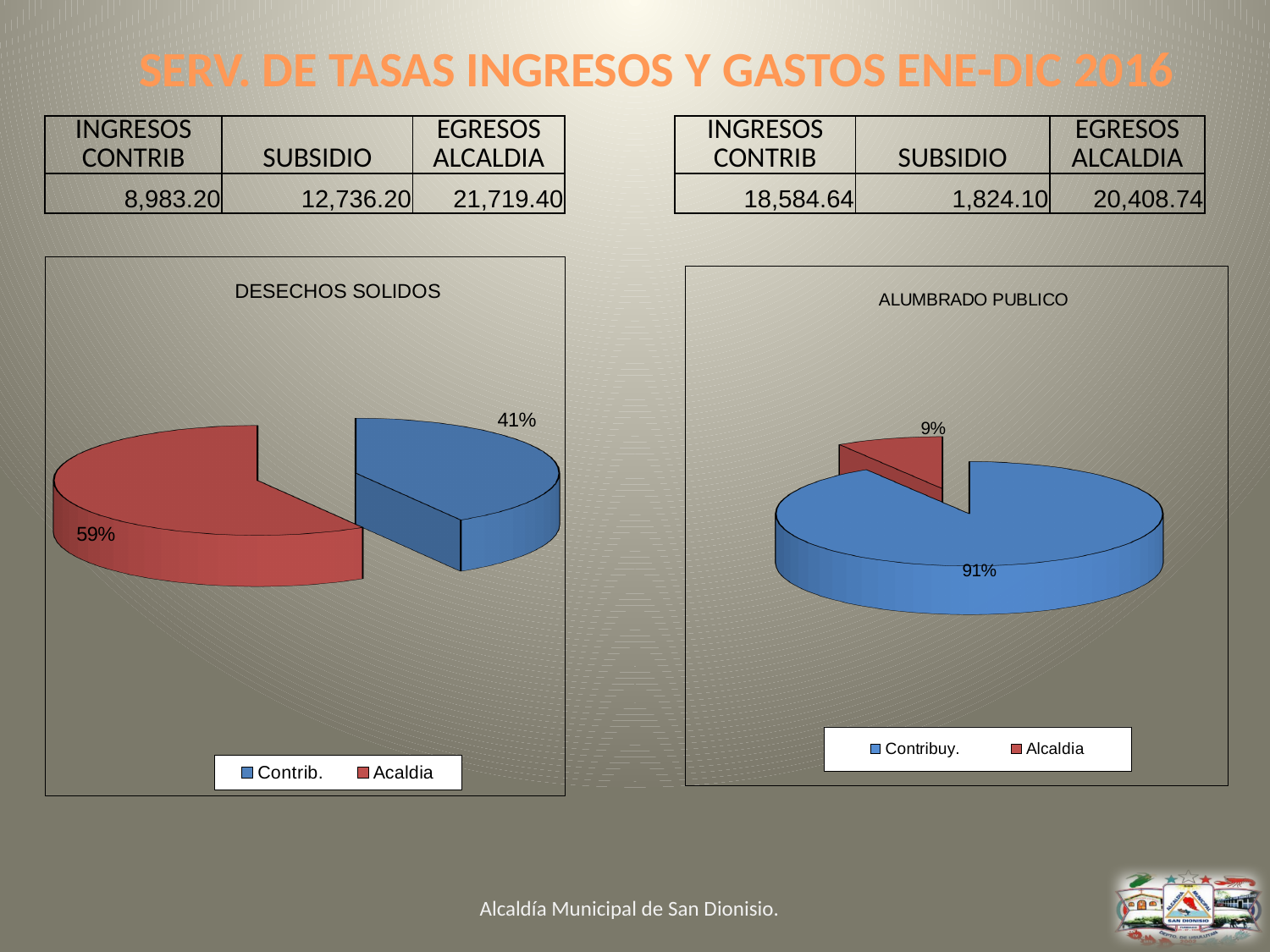
In the DESECHOS SOLIDOS chart, which slice is the largest? Acaldia In the ALUMBRADO PUBLICO chart, what share does Alcaldia have? 9% In the ALUMBRADO PUBLICO chart, which slice is the smallest? Alcaldia In the DESECHOS SOLIDOS chart, what share does Acaldia have? 59% In the ALUMBRADO PUBLICO chart, what is the difference in percentage points between Contribuy. and Alcaldia? 82 How many slices does the ALUMBRADO PUBLICO pie chart have? 2 In the DESECHOS SOLIDOS chart, what share does Contrib. have? 41% What kind of chart is the DESECHOS SOLIDOS chart? Pie chart In the ALUMBRADO PUBLICO chart, which is larger, Contribuy. or Alcaldia? Contribuy. How many entries does the legend of the DESECHOS SOLIDOS chart list? 2 In the DESECHOS SOLIDOS chart, what is the difference in percentage points between Acaldia and Contrib.? 18